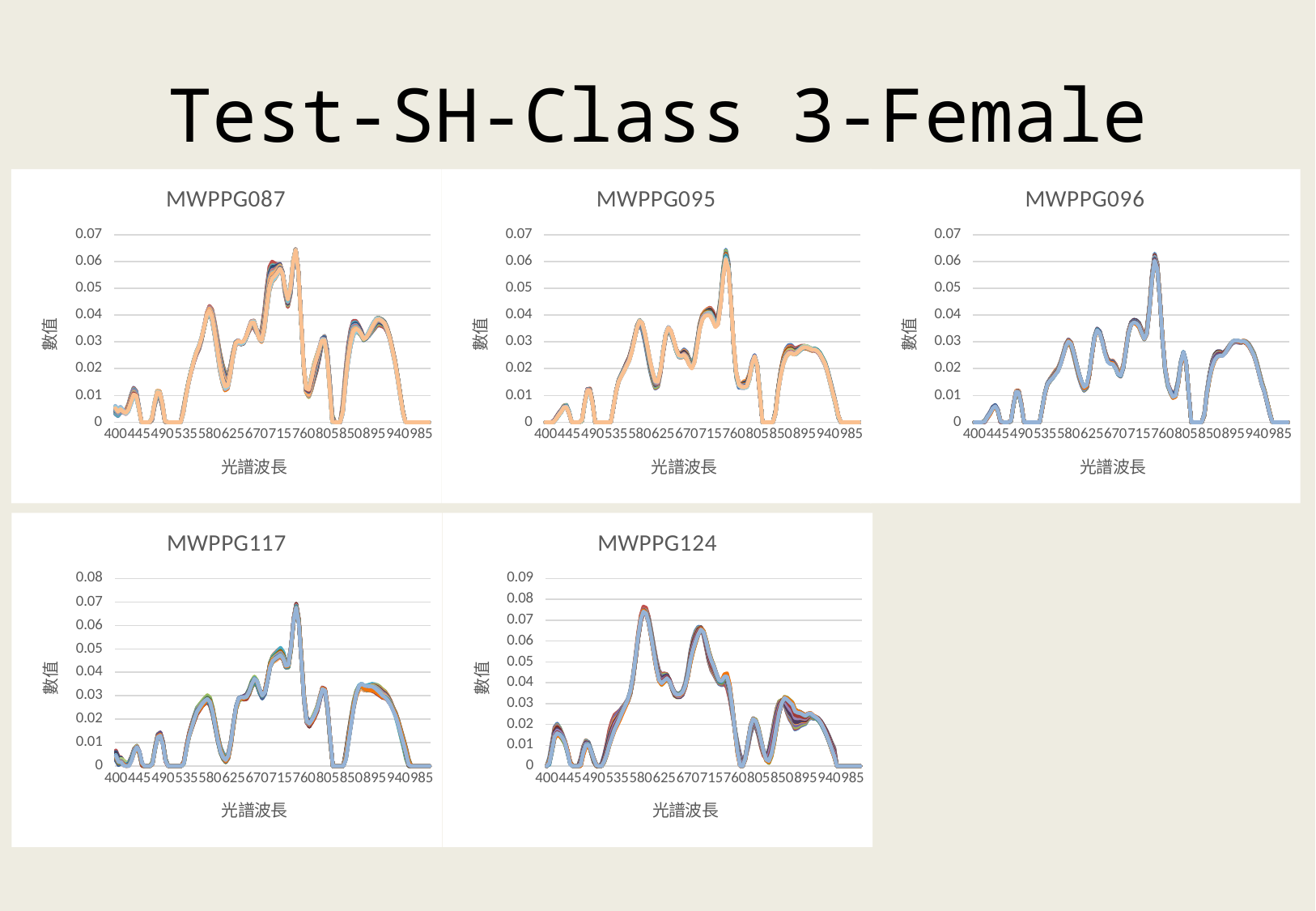
How many charts are shown on the slide? 5 What is the title of the top-left chart? MWPPG087 In the MWPPG124 chart, which is larger: the peak near 580 or the peak near 715? the peak near 580 In the MWPPG087 chart, is the peak value near 760 greater or less than 0.05? greater In the MWPPG096 chart, is the value at 490 greater or less than 0.02? less In the MWPPG096 chart, is the peak value near 760 greater or less than 0.05? greater In the MWPPG096 chart, which is larger: the peak near 760 or the peak near 580? the peak near 760 In the MWPPG124 chart, what is the highest value shown on the y axis? 0.09 What kind of chart is MWPPG087? line chart